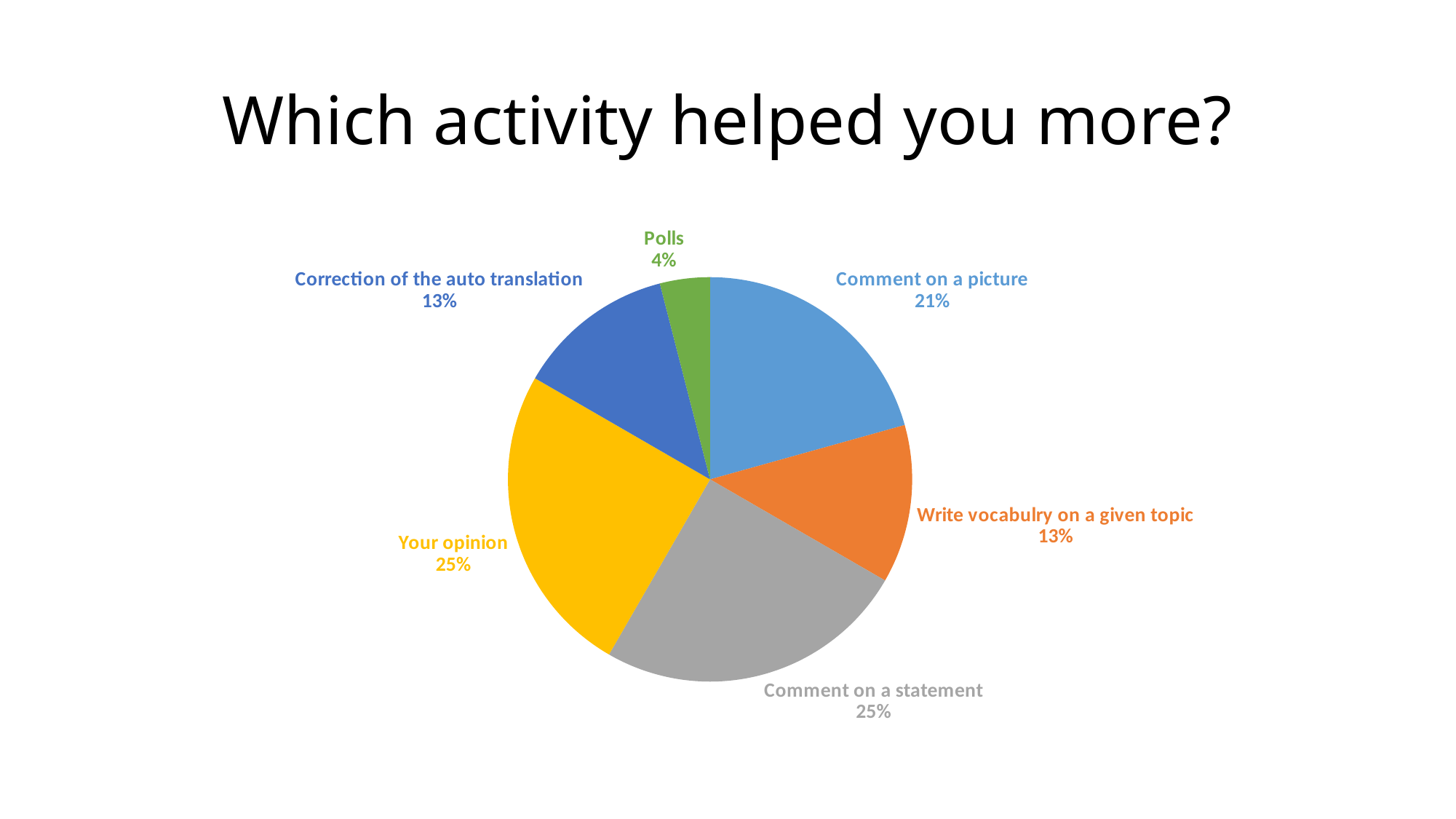
What percentage is shown for "Write vocabulry on a given topic"? 13% Which is larger: the slice for "Comment on a picture" or the slice for "Polls"? Comment on a picture What kind of chart is shown on the slide? pie chart What is the difference in percentage points between "Comment on a statement" and "Polls"? 21 What colour is the "Your opinion" slice? yellow Which activity has the smallest slice of the pie? Polls What percentage is shown for "Polls"? 4% What is the title of the chart on the slide? Which activity helped you more? What share of the pie is labelled "Comment on a picture"? 21% How many slices does the pie chart have? 6 What percentage is shown for "Your opinion"? 25% What percentage is shown for "Correction of the auto translation"? 13%